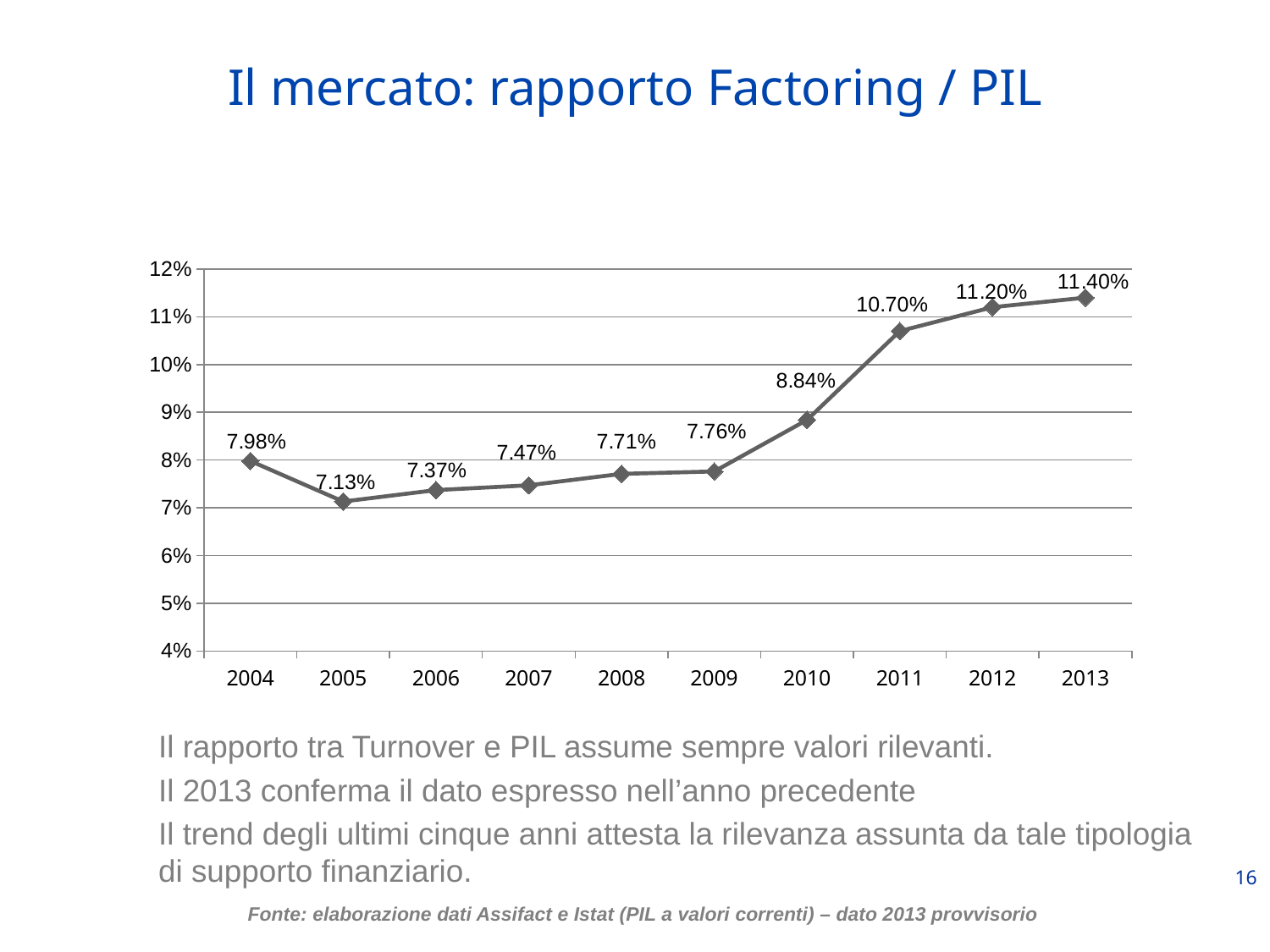
Which year has the lowest value? 2005 What is the difference between the 2013 value and the 2012 value? 0.20% Which year has the highest value? 2013 What kind of chart is shown on the slide? line chart How many years are plotted on the x axis? 10 What is the Factoring / PIL ratio for 2004? 7.98% What is the difference between the 2011 value and the 2010 value? 1.86% What is the value shown for 2010? 8.84% Which is larger, the value for 2006 or the value for 2008? 2008 Do the values rise or fall from 2009 to 2013? rise What is the value shown for 2013? 11.40% Is the value for 2011 greater or less than 10%? greater